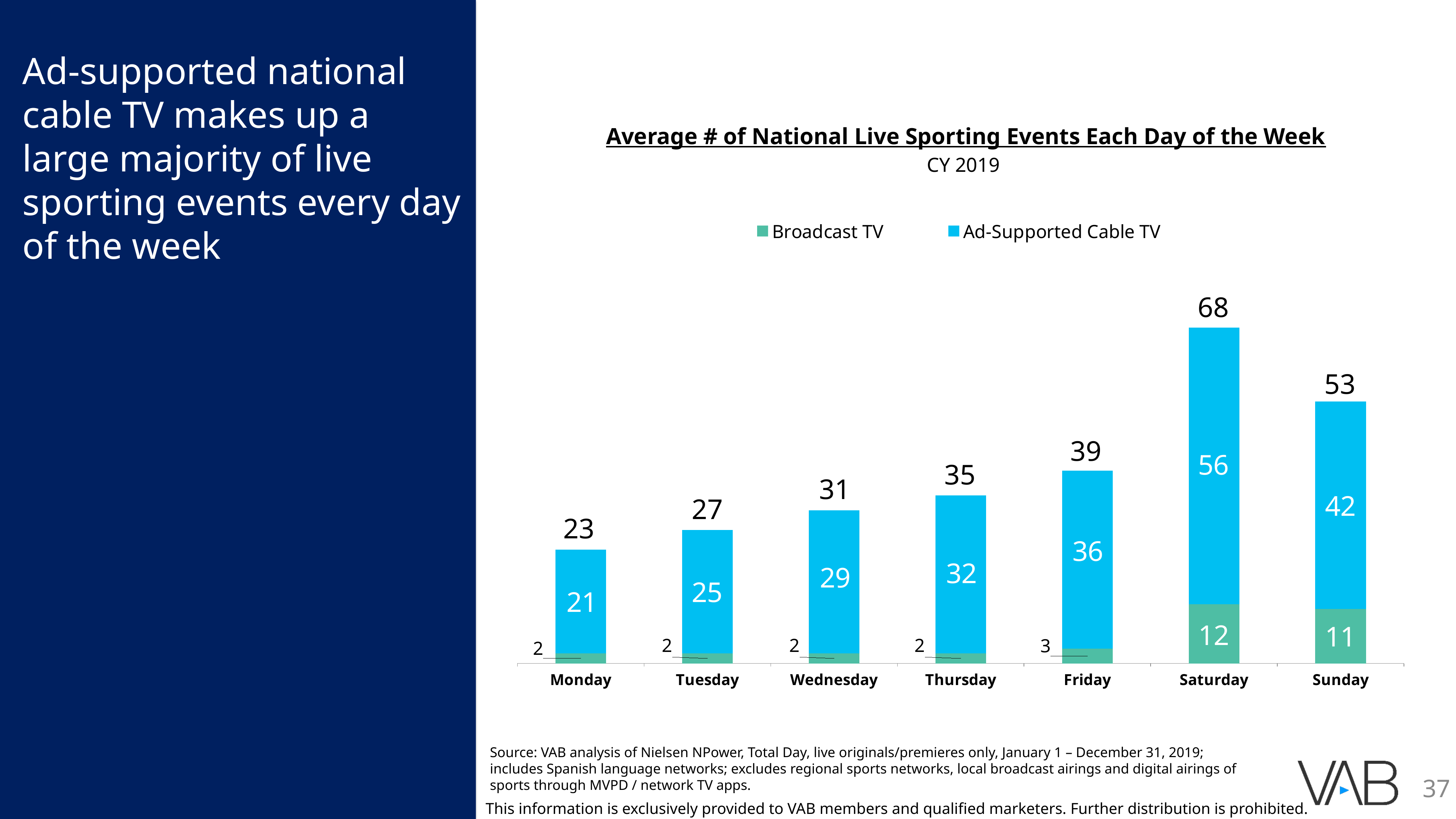
What is the Ad-Supported Cable TV value for Wednesday? 29 How many days of the week are shown on the x axis? 7 Which day has the highest total number of live sporting events? Saturday What is the Broadcast TV value for Friday? 3 Which day has the lowest total number of live sporting events? Monday Which series is shown in green in the legend? Broadcast TV What is the total of the stacked bar for Sunday? 53 What is the Ad-Supported Cable TV value for Saturday? 56 How many series does the legend list? 2 What kind of chart is shown on the slide? Stacked bar chart Which is larger, the Ad-Supported Cable TV value for Thursday or for Friday? Friday What is the difference between the Ad-Supported Cable TV values for Saturday and Sunday? 14